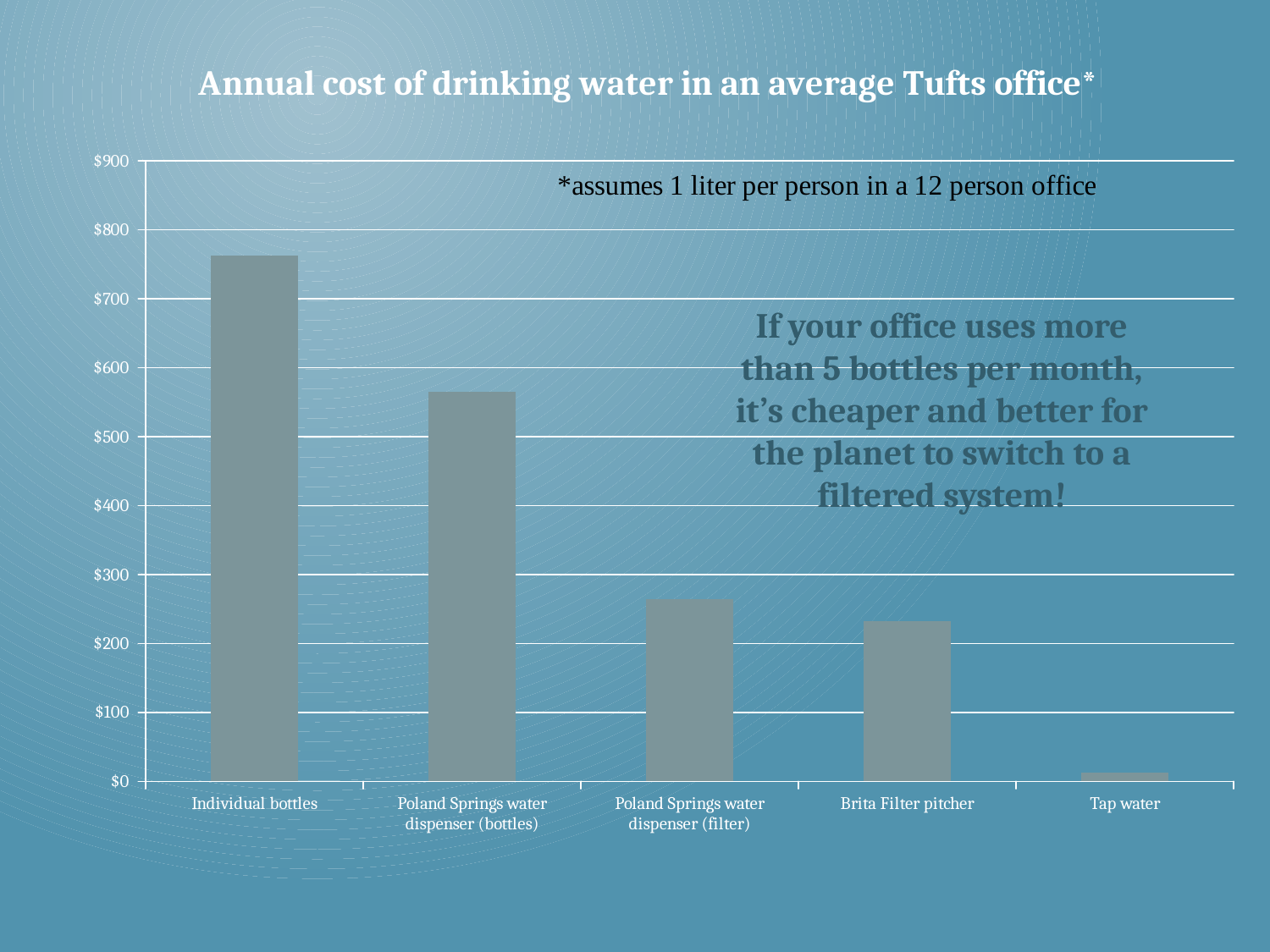
Is the value for Tap water greater or less than $100? less Is the value for Poland Springs water dispenser (bottles) greater or less than $600? less How many categories are shown on the x axis of the chart? 5 Do the values rise or fall moving from left to right along the x axis? fall Which category has the highest annual cost? Individual bottles Is the value for Poland Springs water dispenser (filter) greater or less than $300? less Which category has the lowest annual cost? Tap water Which is larger, the value for Individual bottles or the value for Poland Springs water dispenser (bottles)? Individual bottles What is the title of the chart? Annual cost of drinking water in an average Tufts office* What kind of chart is shown on the slide? bar chart